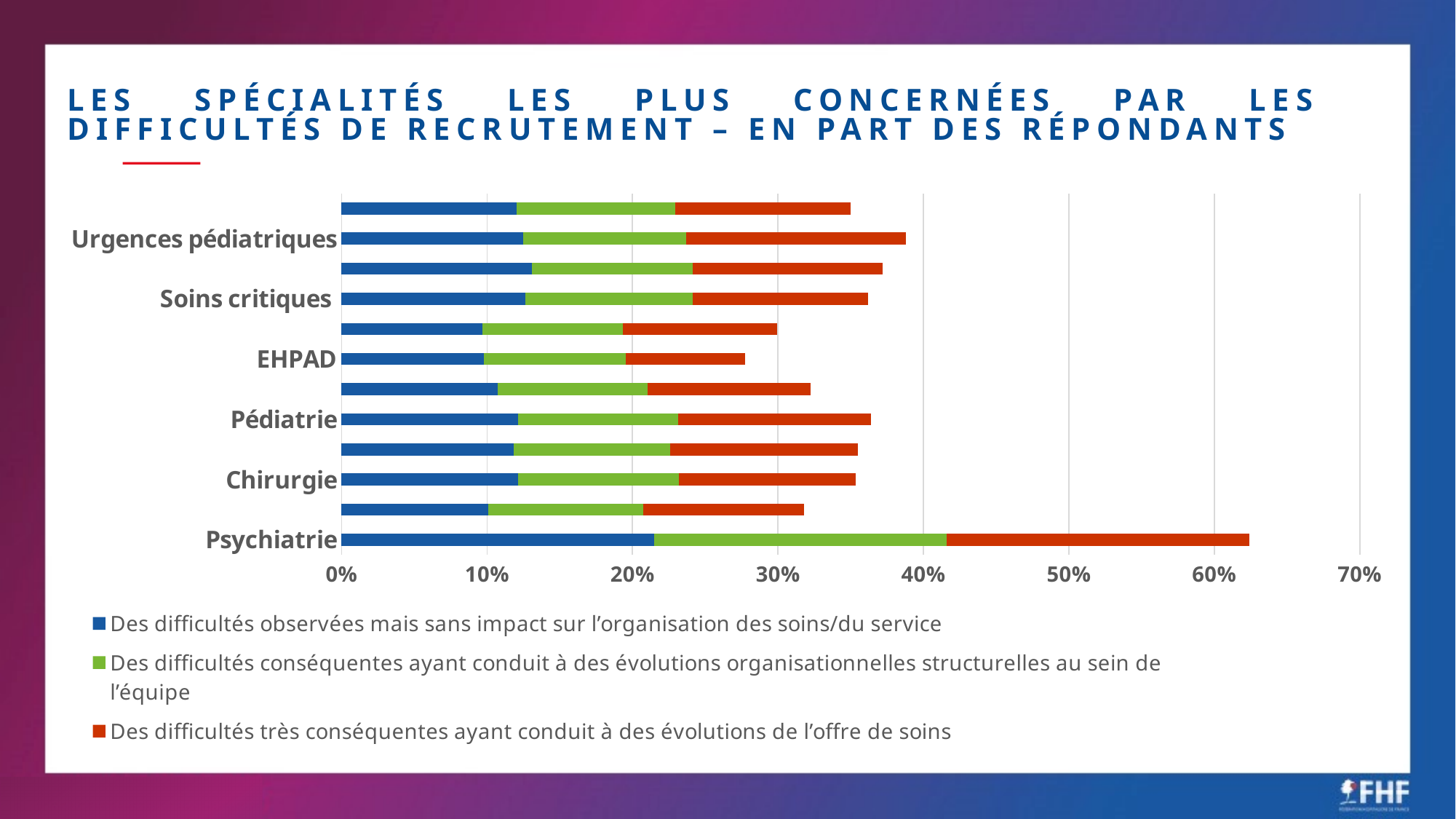
How many series does the legend list? 3 Which has the larger total bar, Psychiatrie or EHPAD? Psychiatrie Is the total bar for EHPAD greater or less than 30%? less Is the total bar for Soins critiques greater or less than 30%? greater Which specialty has the longest total bar? Psychiatrie Is the blue segment (difficultés observées mais sans impact) for Psychiatrie greater or less than 20%? greater Which colour represents 'Des difficultés très conséquentes ayant conduit à des évolutions de l'offre de soins' in the legend? Red What kind of chart is shown on the slide? Stacked horizontal bar chart Among the labelled specialties, which has the shortest total bar? EHPAD Which has the larger total bar, Soins critiques or EHPAD? Soins critiques